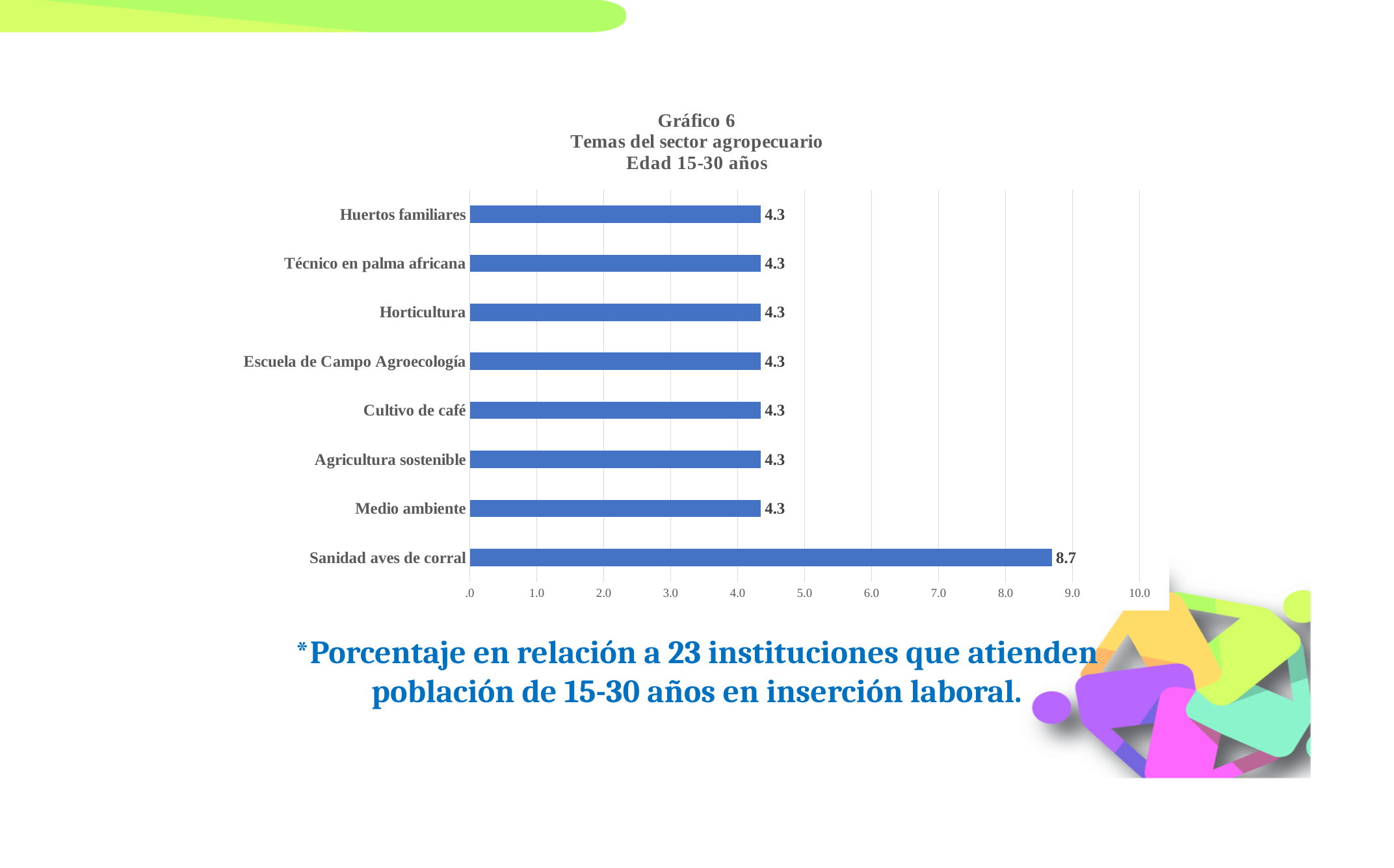
Which is larger, the value for Sanidad aves de corral or the value for Horticultura? Sanidad aves de corral What is the title of the chart? Gráfico 6 Temas del sector agropecuario Edad 15-30 años What is the value for Sanidad aves de corral? 8.7 What is the value for Huertos familiares? 4.3 Which category has the highest value? Sanidad aves de corral How many categories have a value of 4.3? 7 What kind of chart is shown on the slide? Bar chart What is the value for Cultivo de café? 4.3 Is the value for Sanidad aves de corral greater or less than 8.0? greater Is the value for Agricultura sostenible greater or less than 5.0? less What is the difference between the values for Sanidad aves de corral and Medio ambiente? 4.4 How many categories are shown in the chart? 8